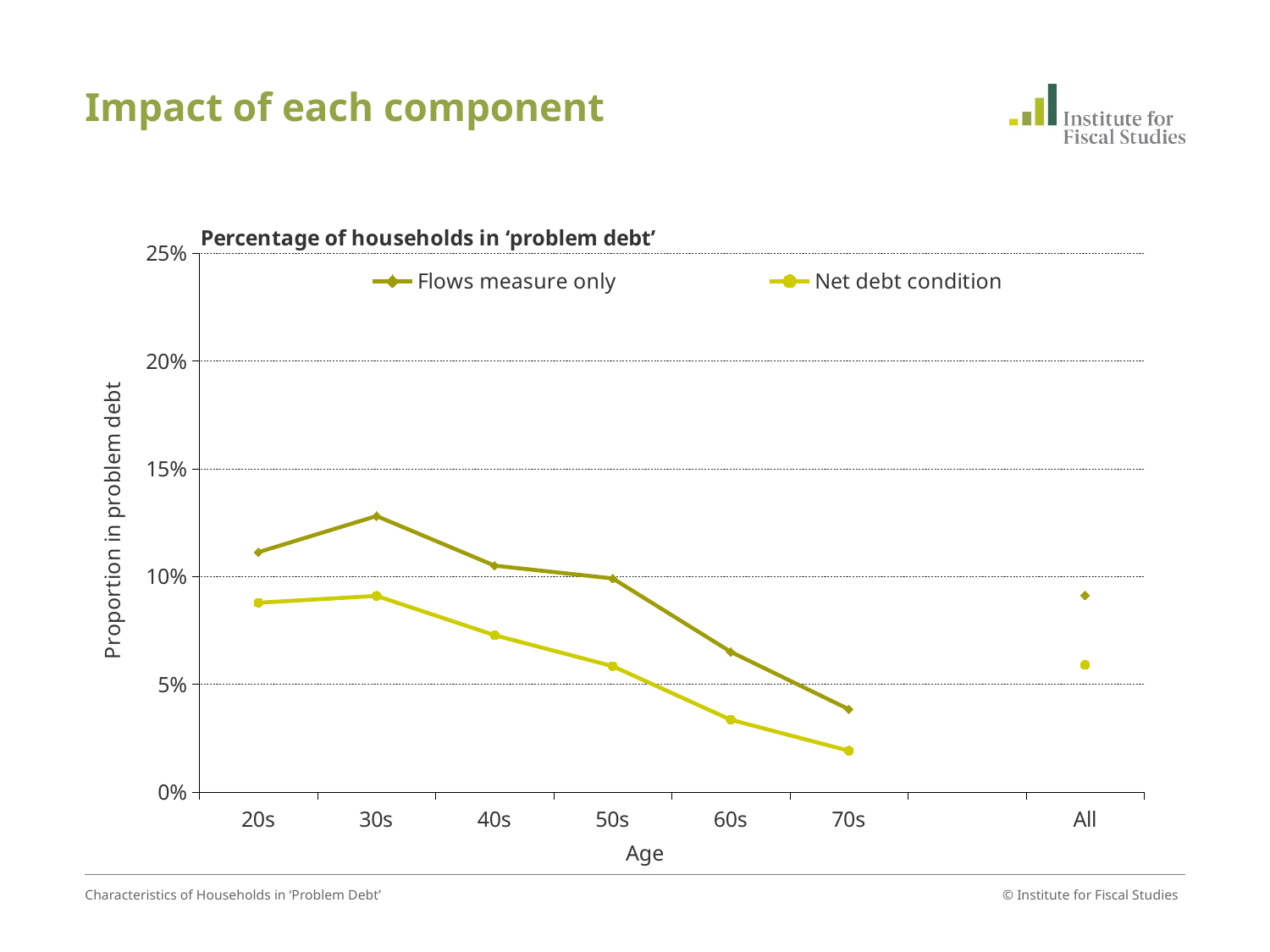
Is the 'Flows measure only' value for the 30s greater or less than 10%? greater Is the 'Net debt condition' value for the 60s greater or less than 5%? less For the 'Flows measure only' series, which age group has the lowest value? 70s For the 'Flows measure only' series, which age group has the highest value? 30s How many series does the legend list? 2 What kind of chart is shown on the slide? line chart How many age categories are shown on the x axis? 7 At the 50s age group, which series has the higher value, 'Flows measure only' or 'Net debt condition'? Flows measure only Is the 'Flows measure only' value for the 70s greater or less than 5%? less For the 'Net debt condition' series, which age group has the lowest value? 70s From the 30s to the 70s, do the 'Net debt condition' values rise or fall? fall